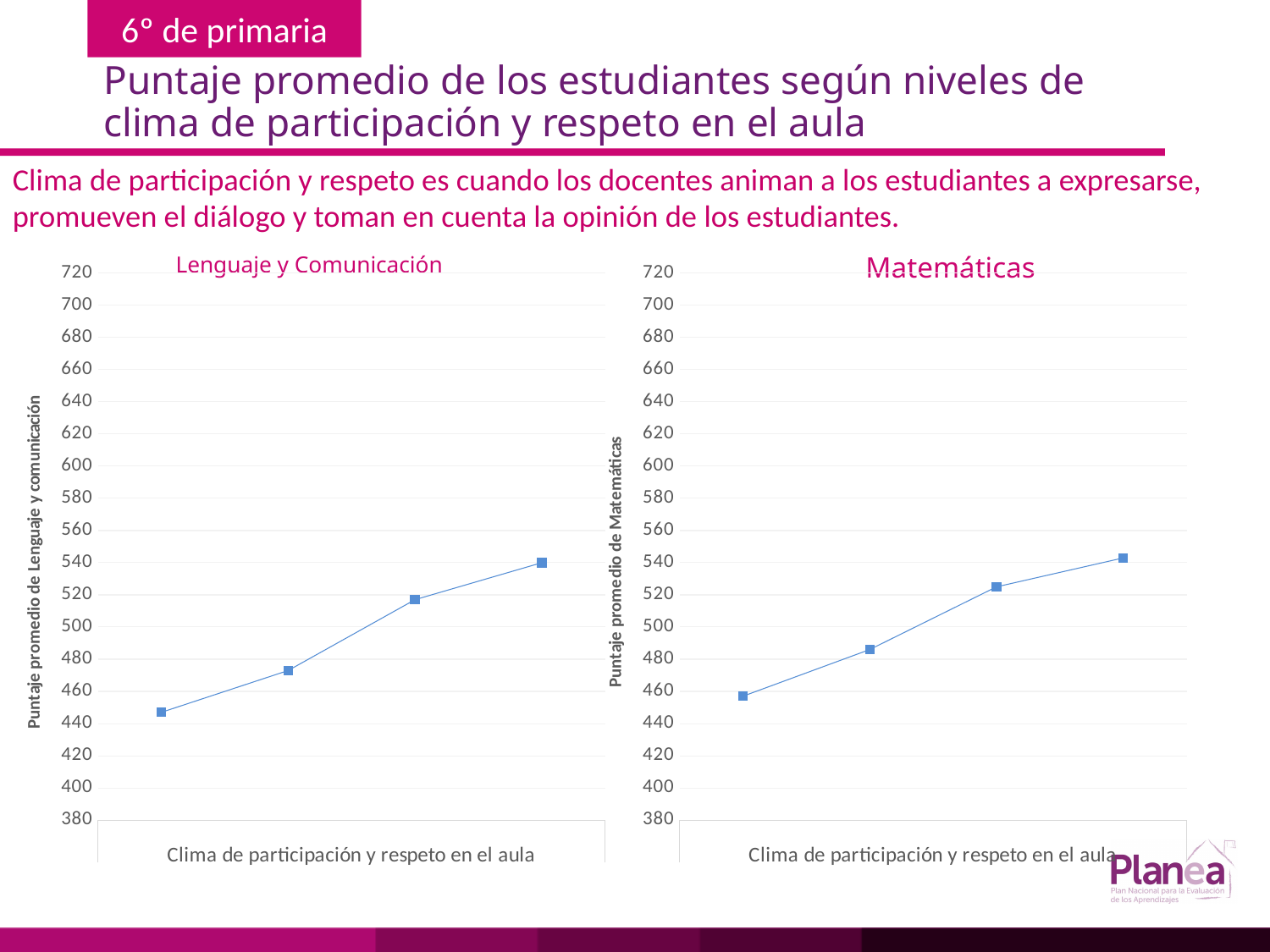
What kind of chart is the Lenguaje y Comunicación chart? line chart On the Matemáticas chart, which point has the lowest value? the first (leftmost) point On the Matemáticas chart, do the values rise or fall from left to right? rise On the Lenguaje y Comunicación chart, do the values rise or fall from left to right? rise On the Lenguaje y Comunicación chart, is the value of the first (leftmost) point greater or less than 460? less How many data points are plotted on the Matemáticas chart? 4 On the Lenguaje y Comunicación chart, is the value of the last (rightmost) point greater or less than 520? greater On the Lenguaje y Comunicación chart, which point has the highest value, the first or the last? the last What is the y-axis title of the Matemáticas chart? Puntaje promedio de Matemáticas What is the x-axis label shown on the Lenguaje y Comunicación chart? Clima de participación y respeto en el aula On the Matemáticas chart, is the value of the third point greater or less than 500? greater